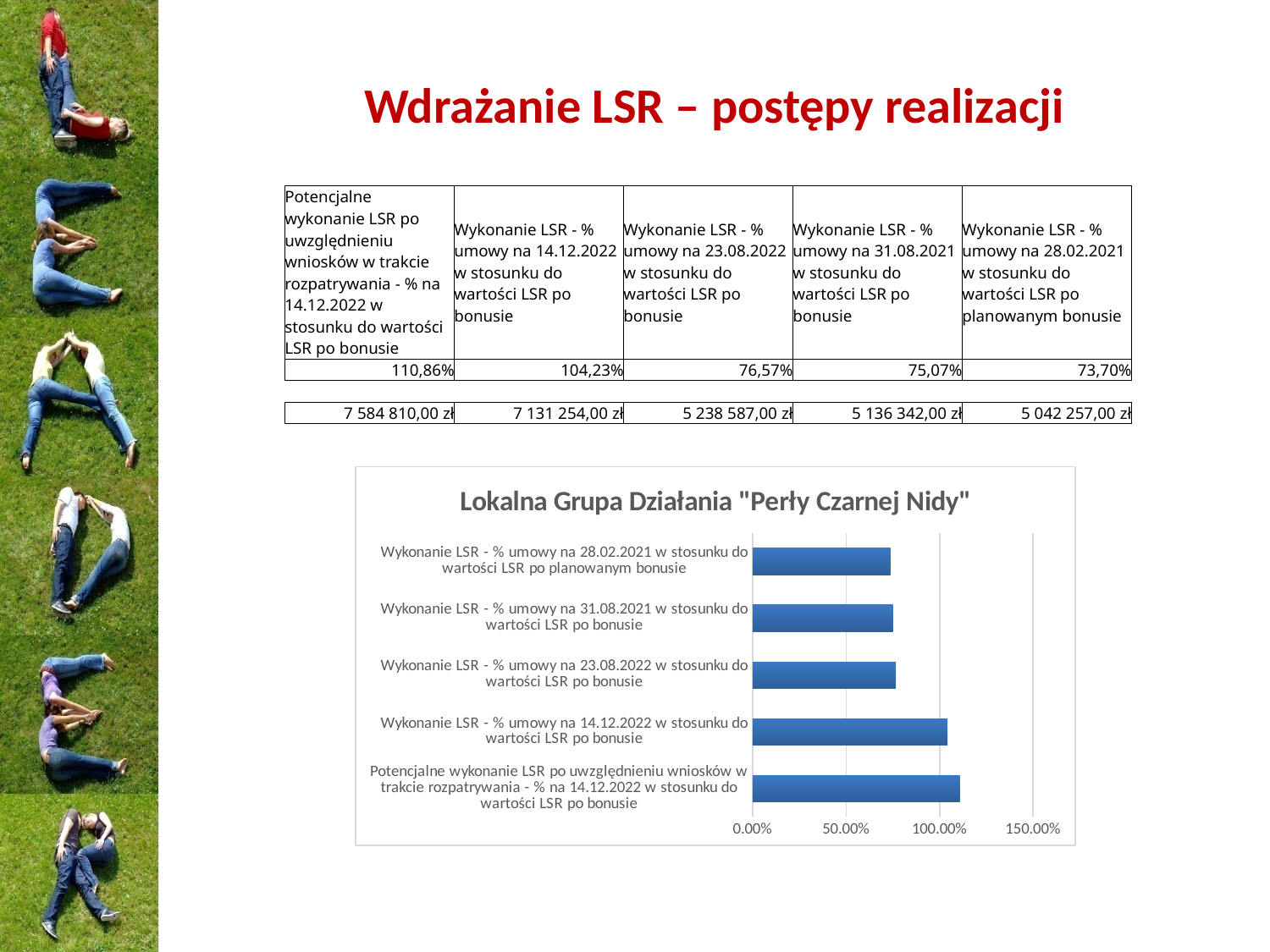
Which category has the longest bar in the chart? Potencjalne wykonanie LSR po uwzględnieniu wniosków w trakcie rozpatrywania - % na 14.12.2022 w stosunku do wartości LSR po bonusie What is the highest tick label shown on the chart's horizontal axis? 150.00% Is the value for "Wykonanie LSR - % umowy na 28.02.2021 w stosunku do wartości LSR po planowanym bonusie" greater or less than 50.00%? greater According to the table above the chart, what is the value for "Potencjalne wykonanie LSR po uwzględnieniu wniosków w trakcie rozpatrywania - % na 14.12.2022 w stosunku do wartości LSR po bonusie"? 110,86% How many bars (categories) does the chart show? 5 Which is larger: the value for "Wykonanie LSR - % umowy na 31.08.2021" or for "Potencjalne wykonanie LSR po uwzględnieniu wniosków w trakcie rozpatrywania"? Potencjalne wykonanie LSR po uwzględnieniu wniosków w trakcie rozpatrywania According to the table above the chart, what is the value for "Wykonanie LSR - % umowy na 14.12.2022 w stosunku do wartości LSR po bonusie"? 104,23% Is the value for "Wykonanie LSR - % umowy na 23.08.2022 w stosunku do wartości LSR po bonusie" greater or less than 100.00%? less Is the value for "Wykonanie LSR - % umowy na 14.12.2022 w stosunku do wartości LSR po bonusie" greater or less than 100.00%? greater What type of chart is shown on the slide? bar chart Which is larger: the value for "Wykonanie LSR - % umowy na 14.12.2022" or for "Wykonanie LSR - % umowy na 23.08.2022"? Wykonanie LSR - % umowy na 14.12.2022 What is the title of the chart? Lokalna Grupa Działania "Perły Czarnej Nidy"